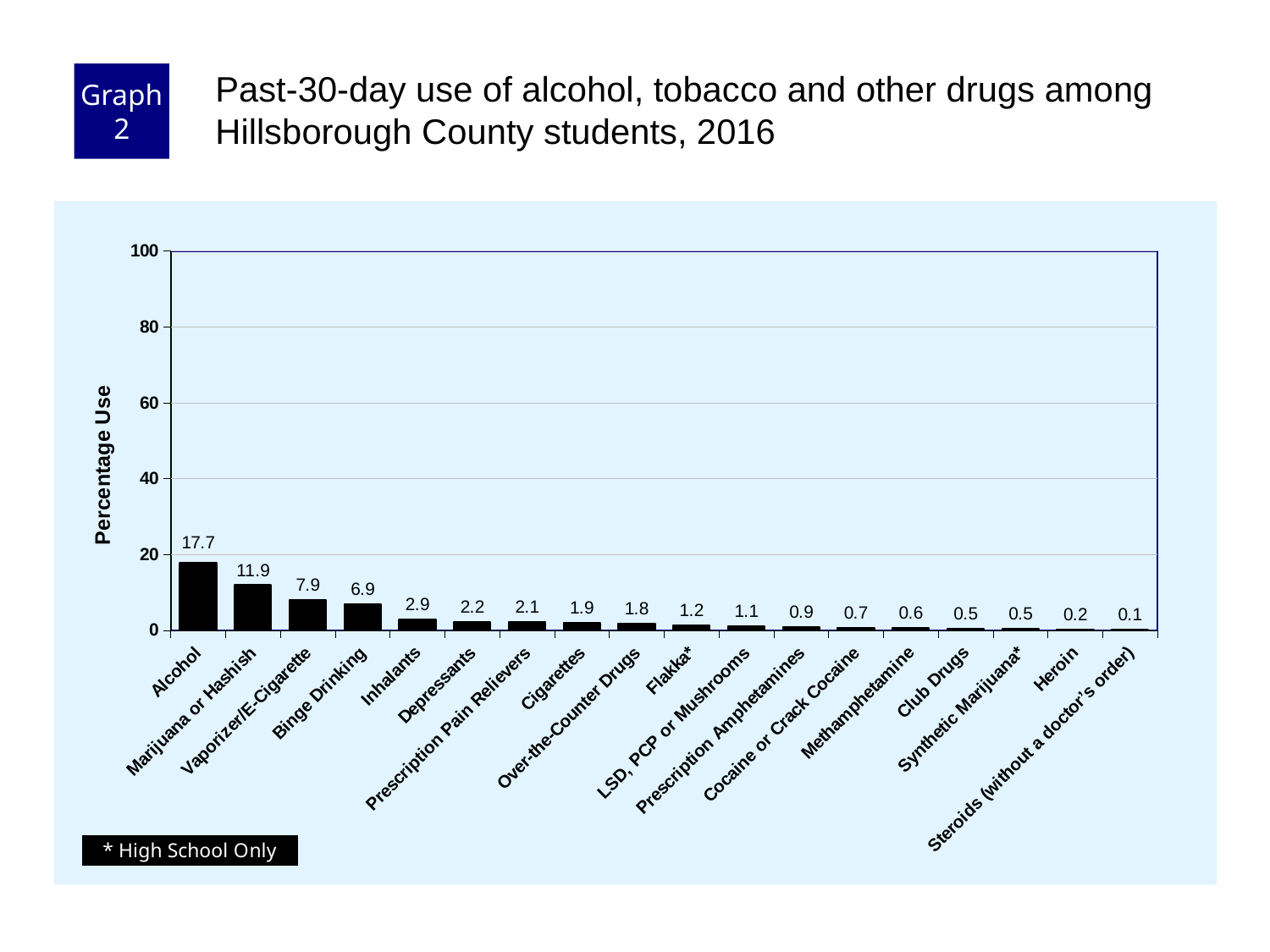
What is the difference in percentage use between Alcohol and Marijuana or Hashish? 5.8 What is the label of the y axis? Percentage Use What kind of chart is shown on the slide? bar chart What is the percentage use for Heroin? 0.2 Is the value for Marijuana or Hashish greater or less than 20? less Which category has the lowest percentage use? Steroids (without a doctor's order) What is the percentage use for Cigarettes? 1.9 How many categories are shown on the x axis? 18 Which has a higher percentage use, Binge Drinking or Inhalants? Binge Drinking What is the percentage use for Vaporizer/E-Cigarette? 7.9 Which category has the highest percentage use? Alcohol What is the percentage use for Alcohol? 17.7